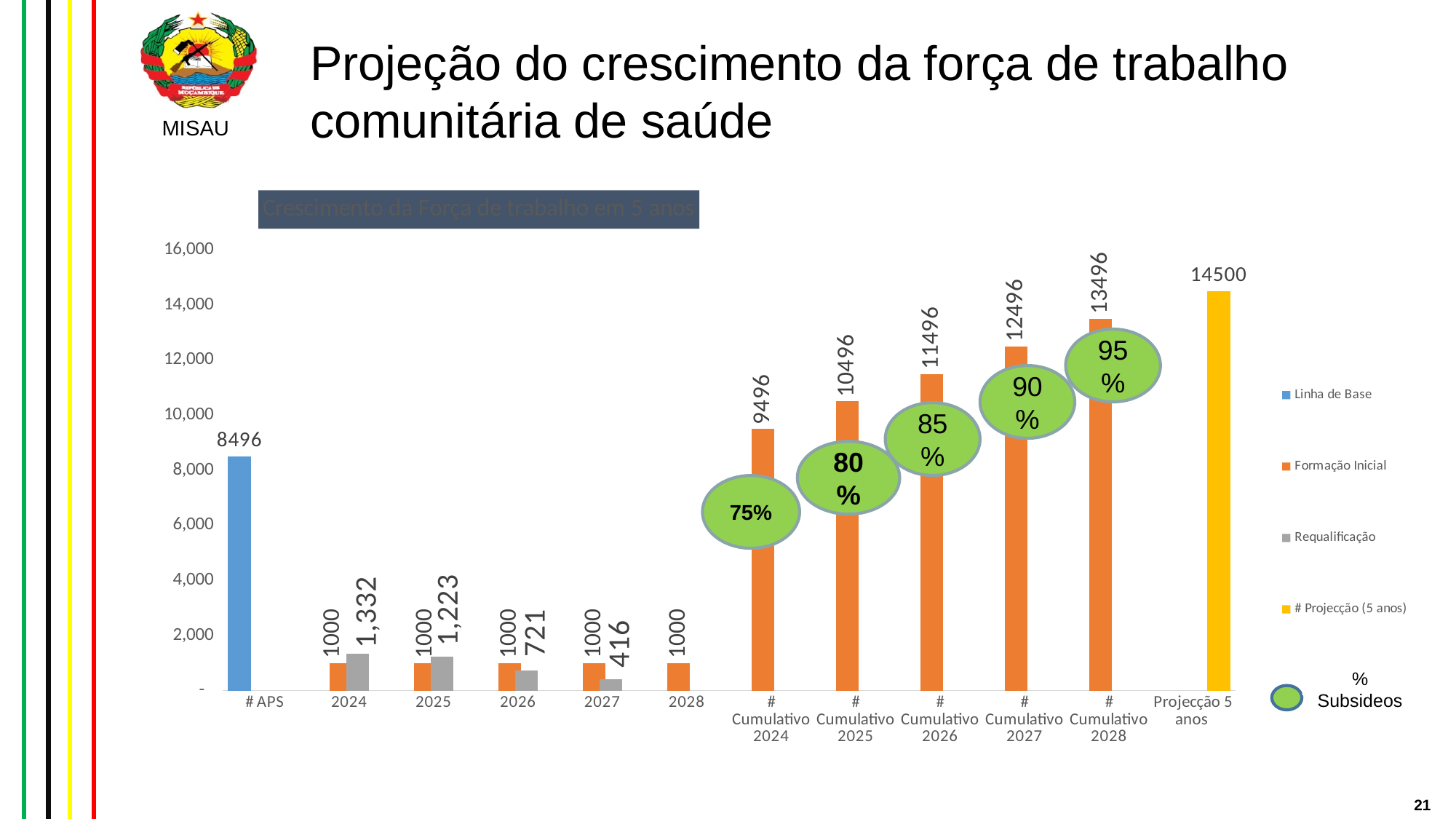
Which year has the lowest Requalificação value? 2027 What is the difference between the Requalificação values for 2024 and 2025? 109 Which is larger, the Requalificação value for 2026 or for 2027? 2026 What is the value of the # Cumulativo 2026 bar? 11496 Which category has the tallest bar in the chart? Projecção 5 anos What is the value of the Linha de Base bar for # APS? 8496 What is the difference between the # Cumulativo 2028 bar and the # Cumulativo 2024 bar? 4000 What kind of chart is shown on the slide? Bar chart What is the value of the Projecção 5 anos bar? 14500 What is the Requalificação value for 2024? 1,332 How many series does the legend list? 4 Do the # Cumulativo bars rise or fall from 2024 to 2028? Rise